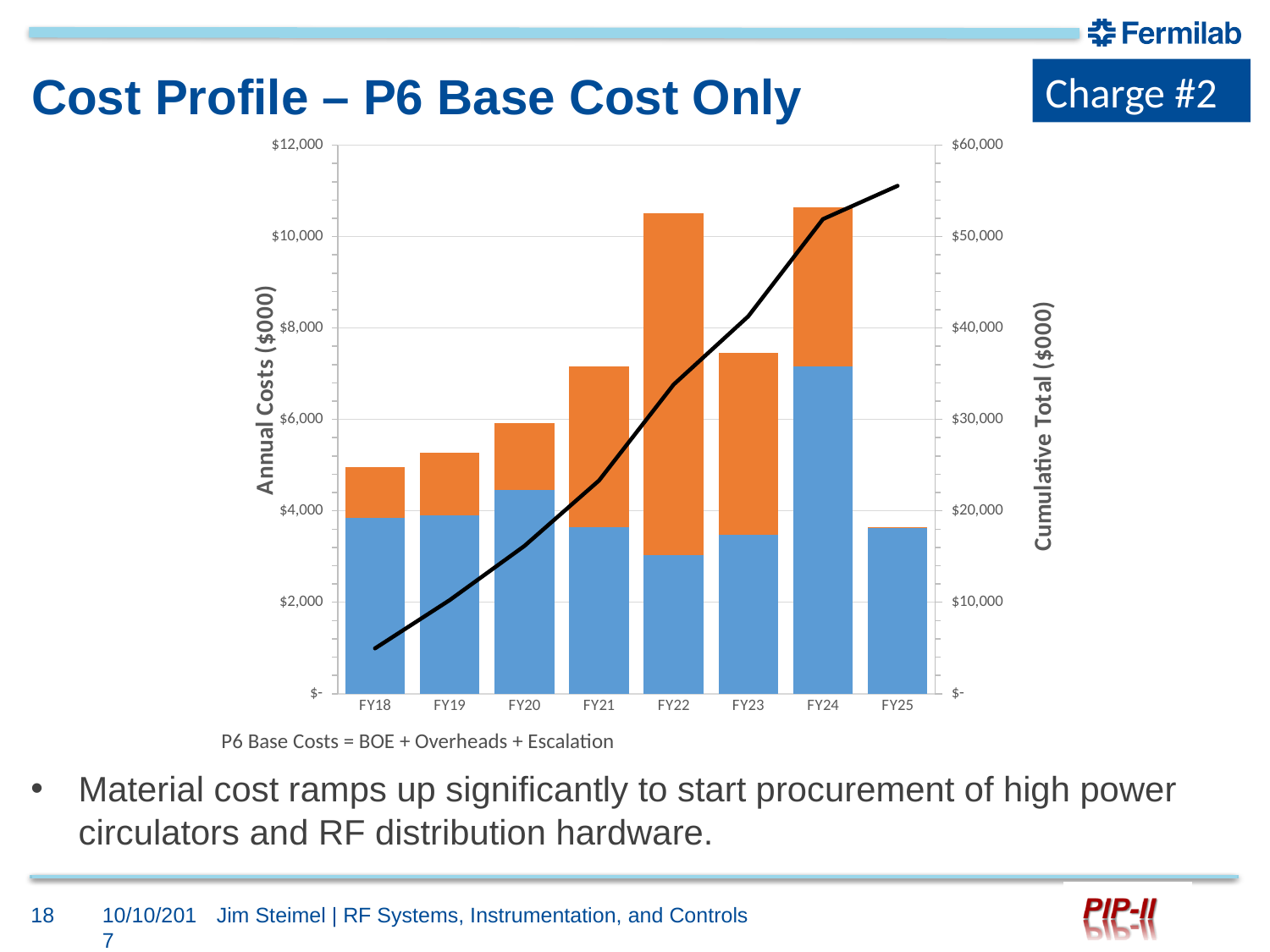
Is the total annual cost bar for FY22 greater or less than $10,000? greater What kind of chart is shown on the slide? Stacked bar chart with a line Which fiscal year has the lowest total annual cost bar? FY25 Is the total annual cost bar for FY21 greater or less than $8,000? less Which fiscal year has the tallest blue bar segment? FY24 Does the cumulative total line rise or fall from FY18 to FY25? Rises How many fiscal years are shown on the x axis of the chart? 8 Is the total annual cost bar for FY25 greater or less than $4,000? less What is the title of the right-hand vertical axis? Cumulative Total ($000) Which fiscal year has the largest orange bar segment? FY22 Which has the larger total annual cost bar, FY22 or FY23? FY22